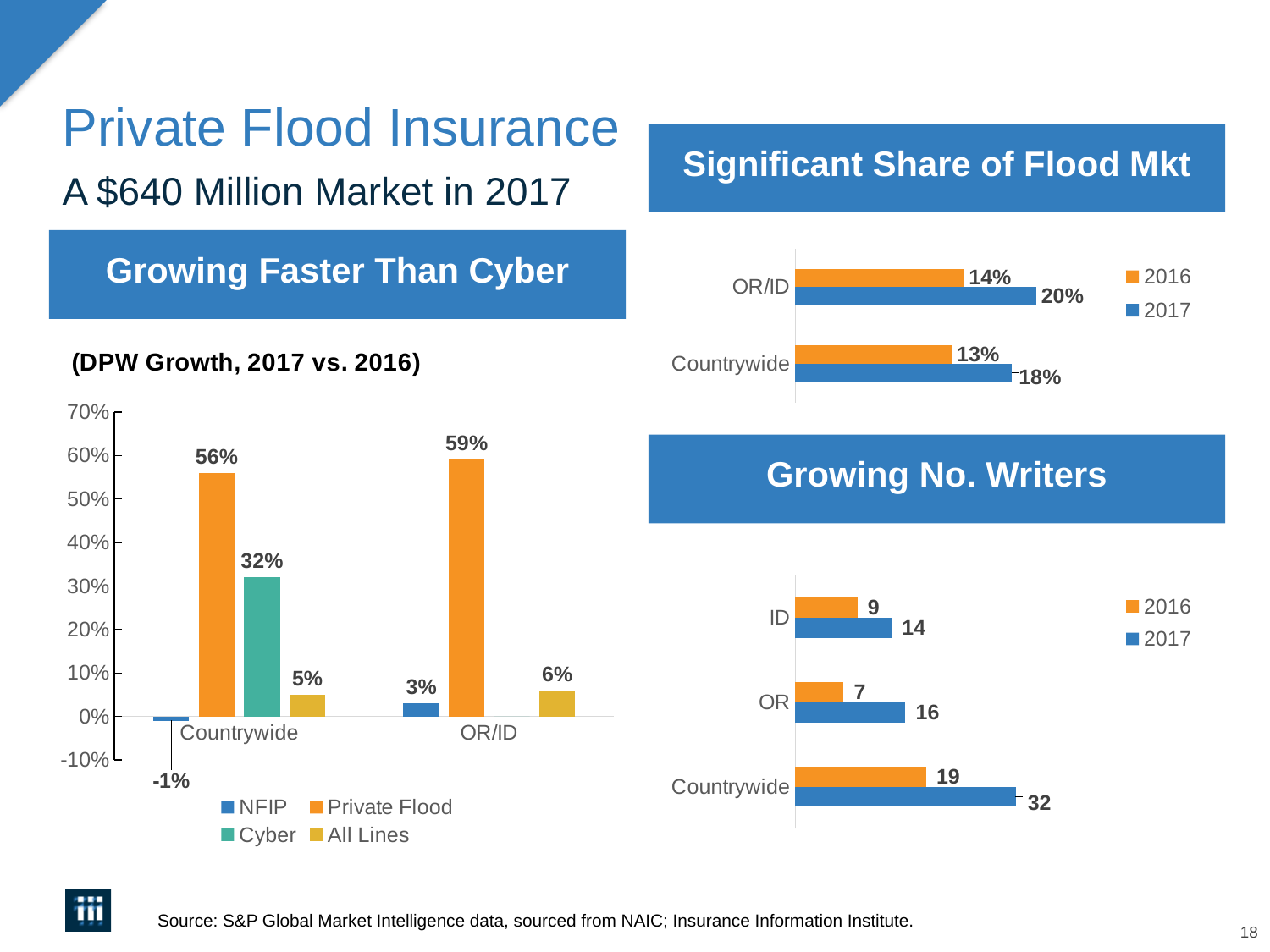
What kind of chart is the 'Significant Share of Flood Mkt' chart? Bar chart In the 'Growing No. Writers' chart, is the 2017 value for ID larger or smaller than the 2017 value for OR? Smaller In the 'Growing No. Writers' chart, which category has the highest 2017 value? Countrywide In the 'Significant Share of Flood Mkt' chart, what is the difference between the 2017 and 2016 values for Countrywide? 5% In the 'Growing Faster Than Cyber' chart, what is the DPW growth for NFIP in the OR/ID group? 3% In the 'Growing Faster Than Cyber' chart, which series has the lowest value in the Countrywide group? NFIP In the 'Growing Faster Than Cyber' chart, what is the DPW growth for Cyber in the Countrywide group? 32% In the 'Growing Faster Than Cyber' chart, what is the DPW growth for Private Flood in the Countrywide group? 56% How many series does the legend of the 'Growing Faster Than Cyber' chart list? 4 In the 'Growing No. Writers' chart, what is the 2016 value for OR? 7 In the 'Significant Share of Flood Mkt' chart, what is the 2017 value for OR/ID? 20% In the 'Growing Faster Than Cyber' chart, what is the difference between Private Flood growth in OR/ID and Private Flood growth Countrywide? 3%